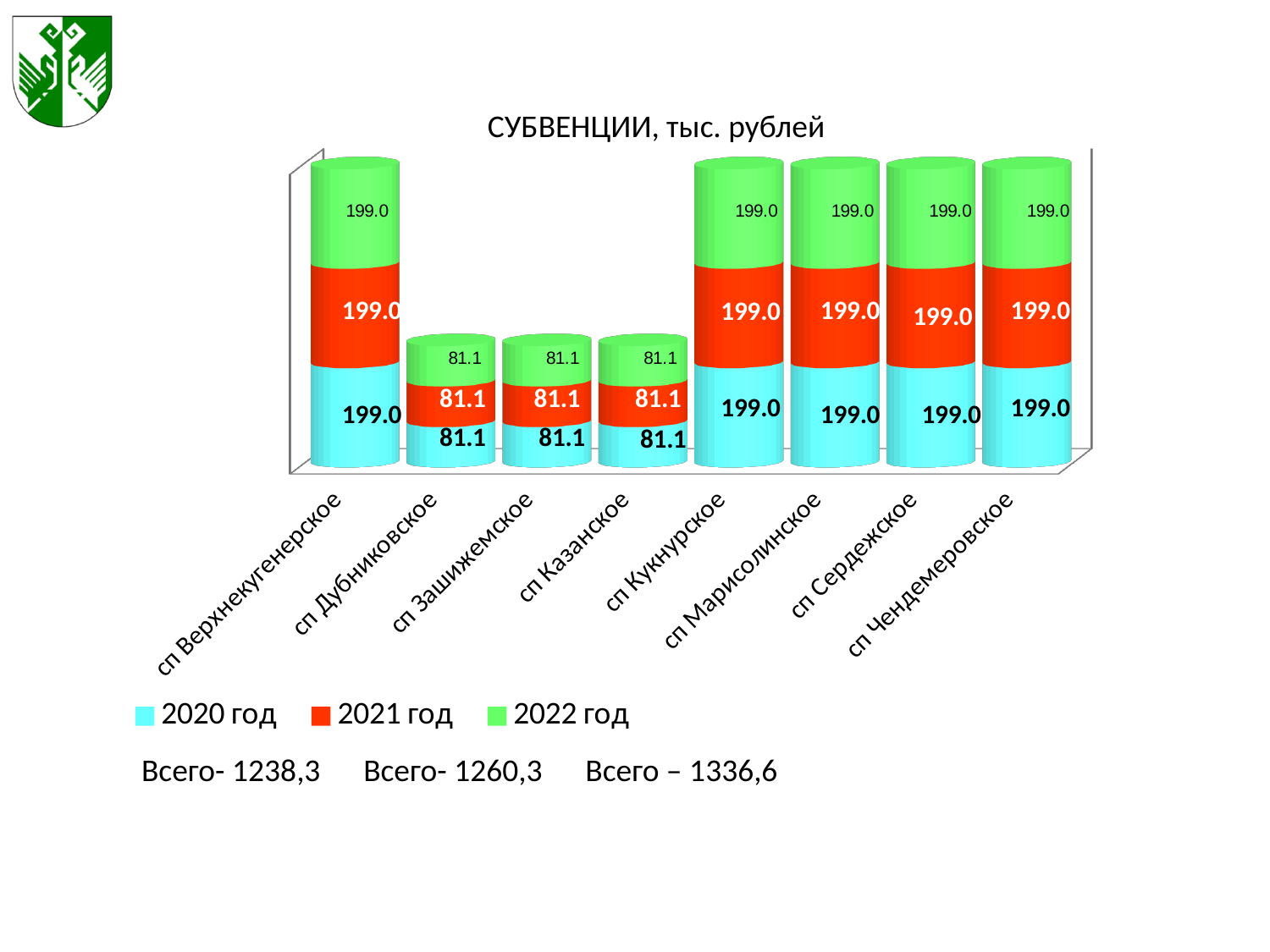
Which is larger, the 2022 год value for сп Сердежское or for сп Дубниковское? сп Сердежское Which colour represents the 2021 год series in the legend? Red What is the value for сп Кукнурское in 2022 год? 199.0 What is the total of the stacked bar for сп Казанское? 243.3 What is the value for сп Верхнекугенерское in 2020 год? 199.0 What is the title of the chart? СУБВЕНЦИИ, тыс. рублей How many categories are shown on the x axis? 8 What is the total of the stacked bar for сп Чендемеровское? 597.0 What is the difference between the 2020 год values for сп Марисолинское and сп Зашижемское? 117.9 What is the value for сп Дубниковское in 2021 год? 81.1 How many series does the legend list? 3 What kind of chart is shown on the slide? Stacked bar chart